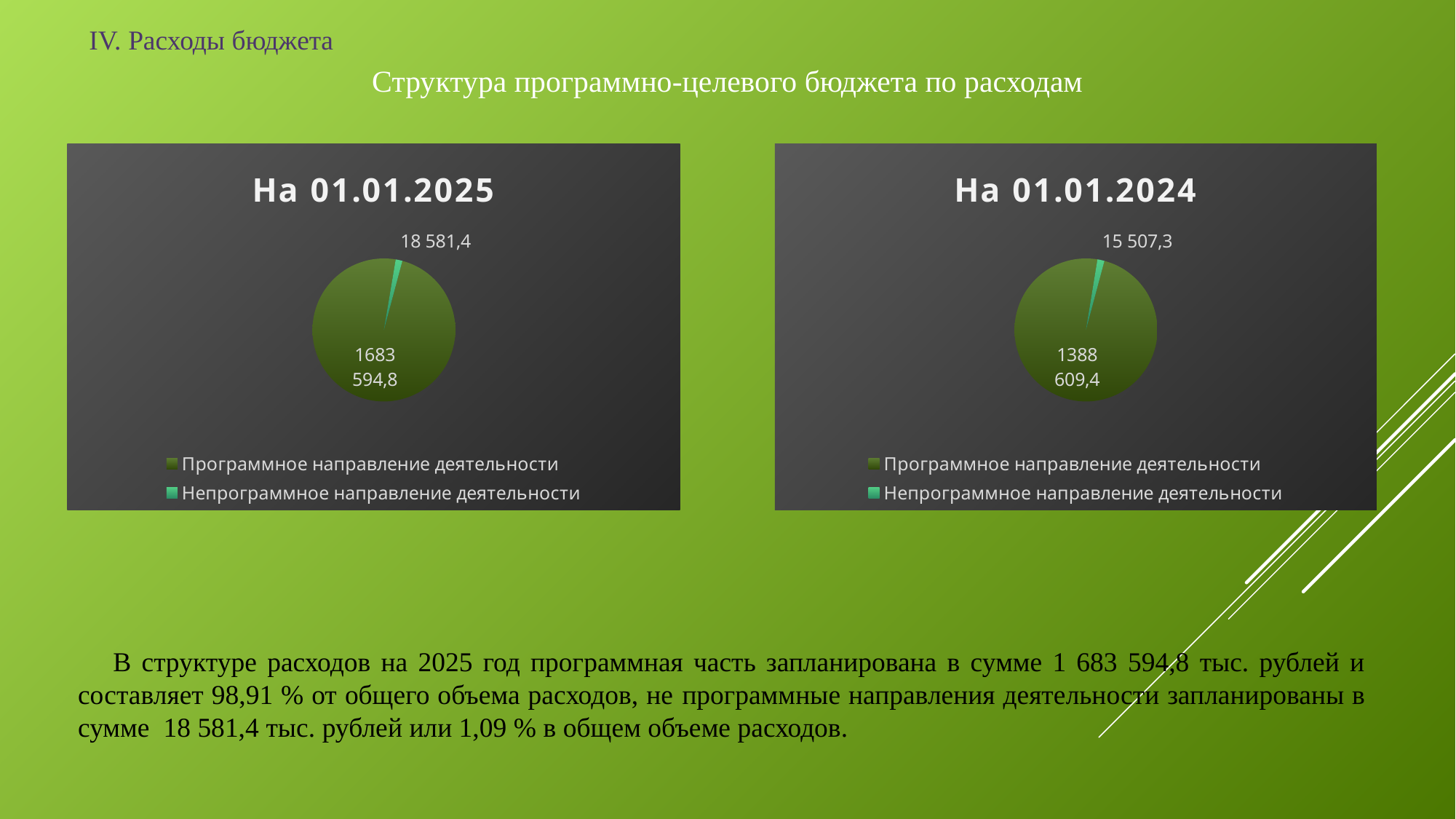
On the chart titled "На 01.01.2025", what is the value for Непрограммное направление деятельности? 18 581,4 According to the slide, what share of total expenditures does Непрограммное направление деятельности make up on the chart titled "На 01.01.2025"? 1,09 % How many entries does the legend of the chart titled "На 01.01.2025" list? 2 On the chart titled "На 01.01.2025", what is the difference between Программное направление деятельности and Непрограммное направление деятельности? 1665 013,4 How many categories does the chart titled "На 01.01.2024" show? 2 On the chart titled "На 01.01.2025", what is the value for Программное направление деятельности? 1683 594,8 On the chart titled "На 01.01.2024", which category has the smallest slice? Непрограммное направление деятельности On the chart titled "На 01.01.2024", what is the value for Программное направление деятельности? 1388 609,4 On the chart titled "На 01.01.2024", what is the value for Непрограммное направление деятельности? 15 507,3 What kind of chart is the chart titled "На 01.01.2024"? Pie chart Is the value for Непрограммное направление деятельности larger on the chart titled "На 01.01.2025" or on the chart titled "На 01.01.2024"? На 01.01.2025 On the chart titled "На 01.01.2025", which category has the largest slice? Программное направление деятельности